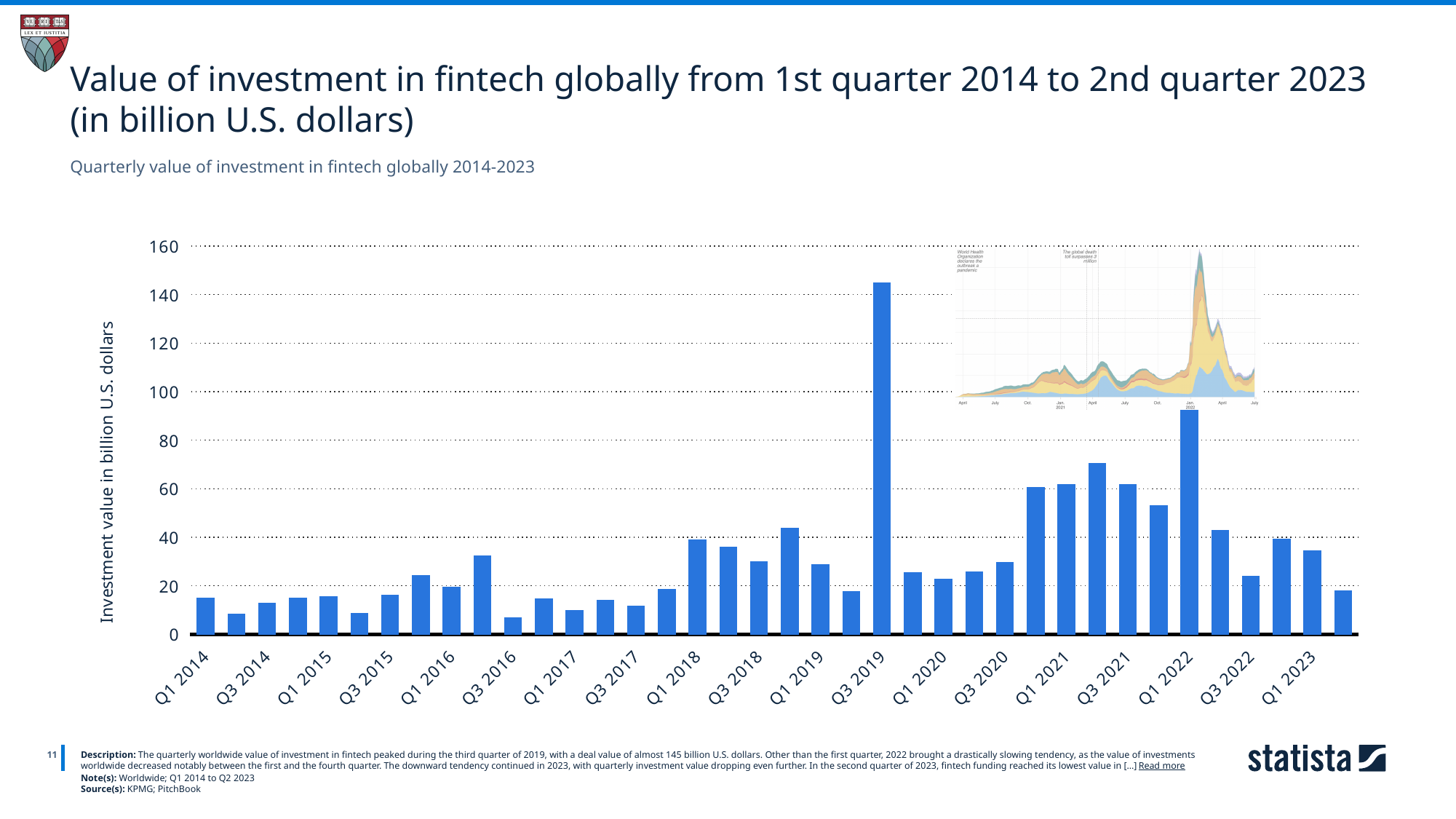
Is the value for Q3 2021 greater or less than 80? less What sources are cited for the chart? KPMG; PitchBook Is the value for Q3 2016 greater or less than 20? less Is the value for Q3 2019 greater or less than 140? greater What is the label of the vertical axis? Investment value in billion U.S. dollars What kind of chart is shown on the slide? Bar chart Which is larger, the value for Q3 2019 or the value for Q1 2022? Q3 2019 Do the values generally rise or fall from Q1 2022 to the last quarter shown? fall Which is larger, the value for Q1 2022 or the value for Q1 2021? Q1 2022 Which quarter has the highest value of fintech investment? Q3 2019